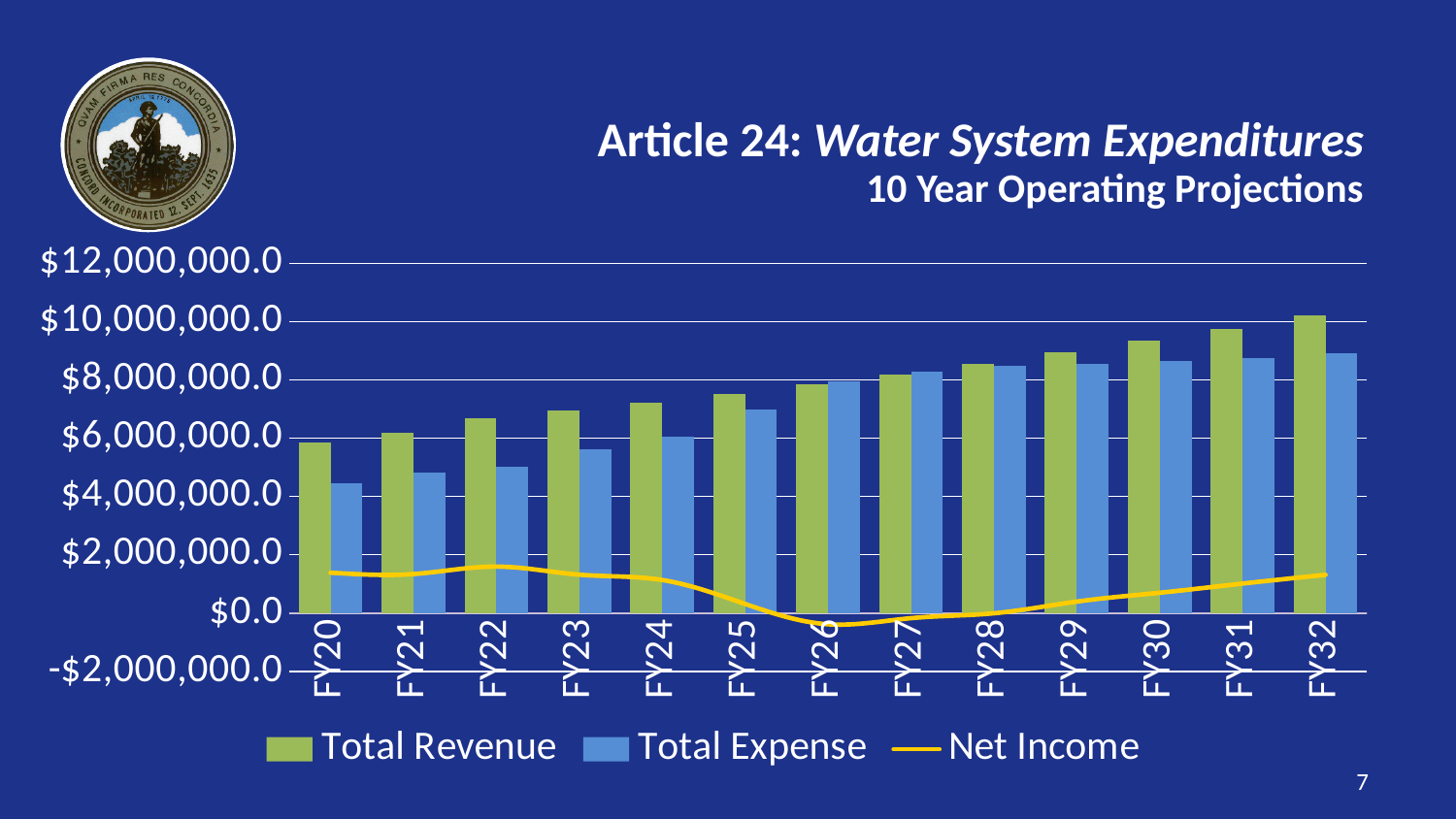
In FY20, which is larger, Total Revenue or Total Expense? Total Revenue Is the Total Expense value for FY20 greater or less than $4,000,000? greater Is the Total Revenue value for FY30 greater or less than $8,000,000? greater What kind of chart is shown on the slide? A bar chart combined with a line Does Total Revenue generally rise or fall from FY20 to FY32? Rise How many series does the chart legend list? 3 Which fiscal year has the highest Total Revenue? FY32 Is the Net Income value for FY26 greater or less than $0? less How many fiscal years are shown on the x axis of the chart? 13 Which fiscal year has the lowest Total Expense? FY20 Which series in the chart is drawn as a line rather than bars? Net Income